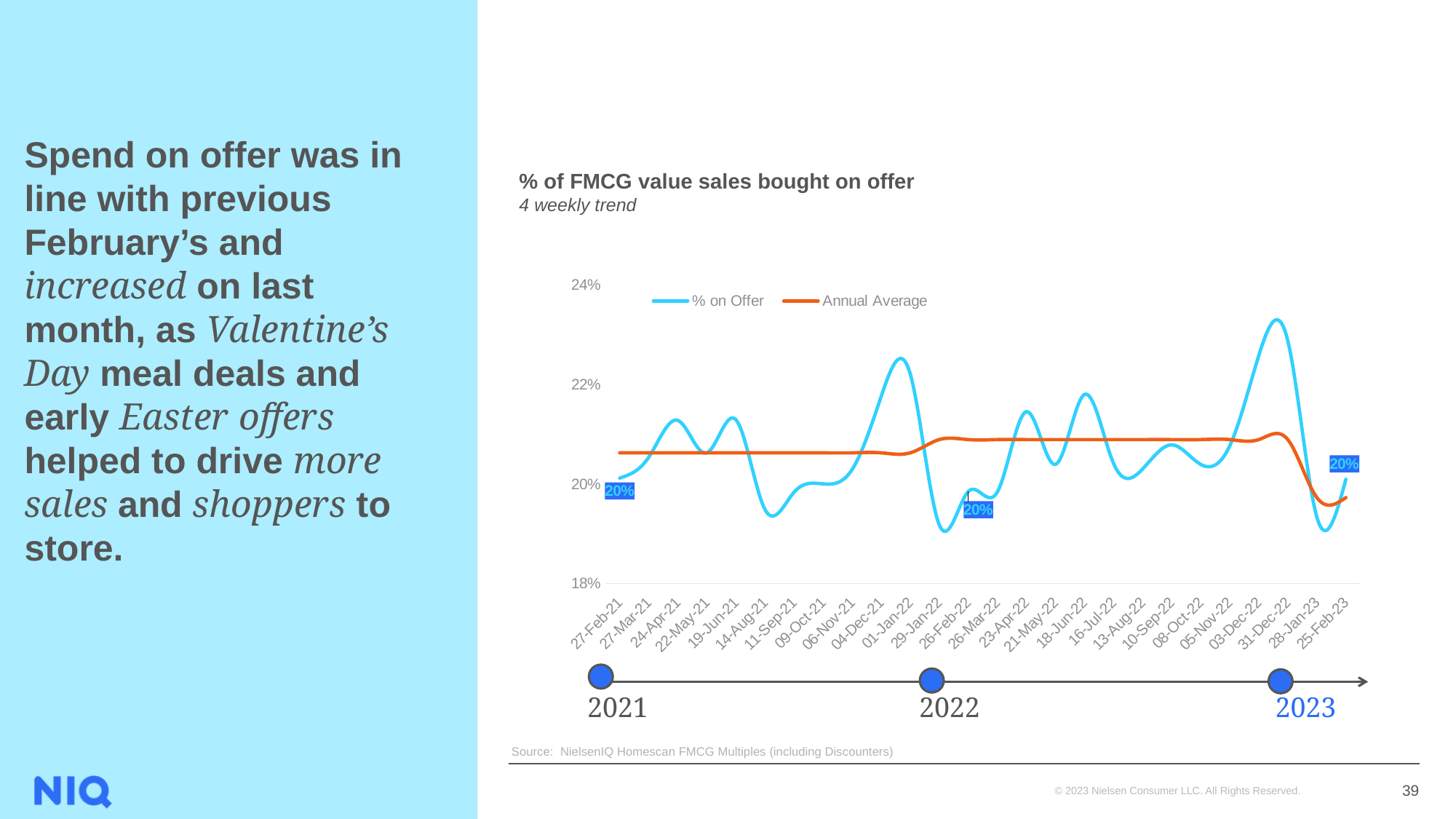
What are the two series named in the chart legend? % on Offer and Annual Average What is the labelled value of % on Offer at 25-Feb-23? 20% Is the Annual Average value at 26-Feb-22 greater or less than 22%? less What is the title of the chart? % of FMCG value sales bought on offer Which date shows the highest % on Offer value on the chart? 31-Dec-22 What is the labelled value of % on Offer at 27-Feb-21? 20% Is the % on Offer value at 03-Dec-22 greater or less than 22%? greater What kind of chart is shown on the slide? Line chart Is the % on Offer value at 28-Jan-23 greater or less than 20%? less How many series does the chart legend list? 2 Which is higher for % on Offer: the peak at 01-Jan-22 or the peak at 03-Dec-22? 03-Dec-22 What is the labelled value of % on Offer at 26-Feb-22? 20%